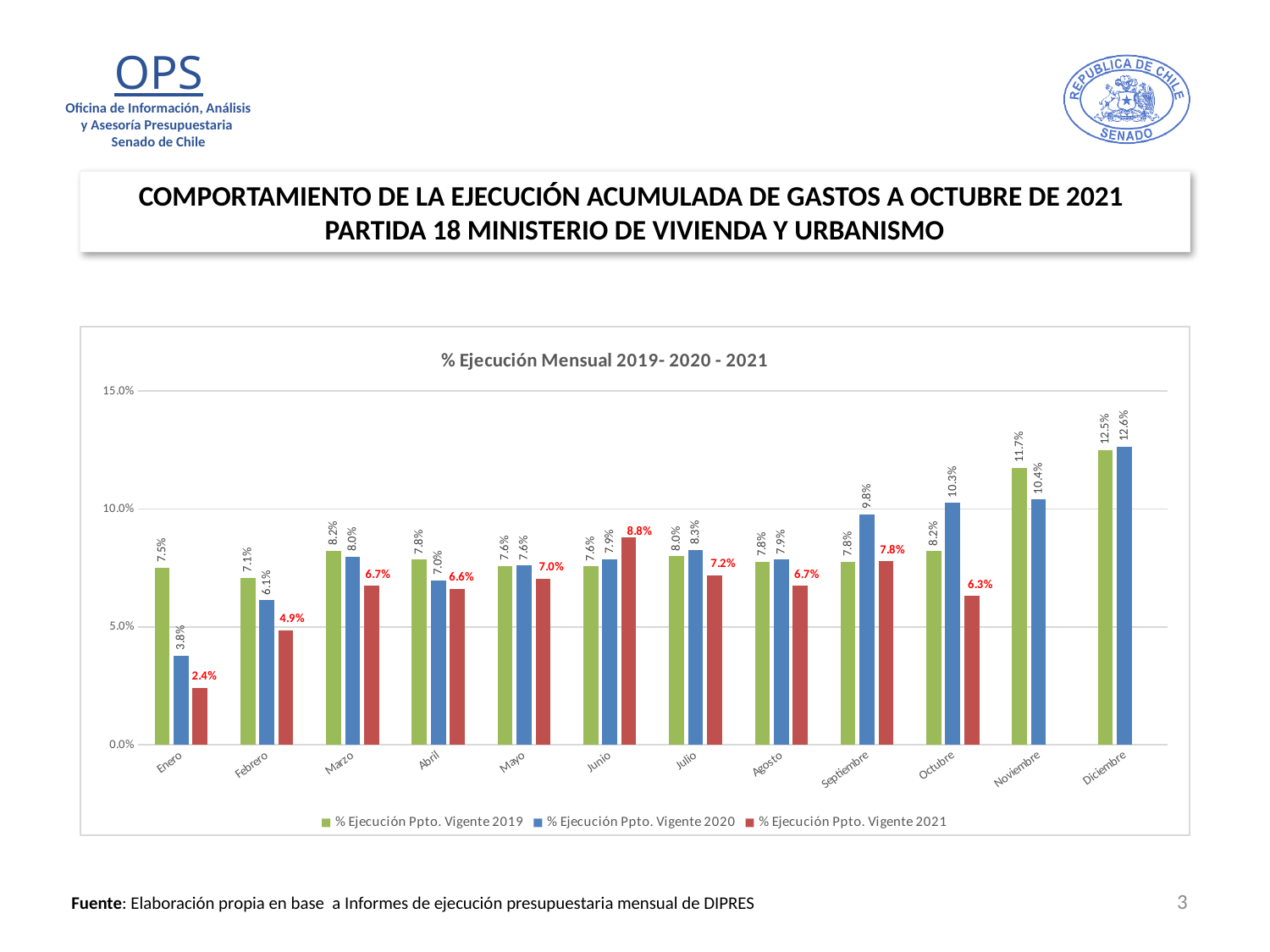
Is the value for % Ejecución Ppto. Vigente 2019 in Diciembre greater or less than 10.0%? greater How many months are shown on the x axis? 12 In which month is the % Ejecución Ppto. Vigente 2020 series lowest? Enero What is the difference between the 2020 and 2021 values in Octubre? 4.0% Which is larger in Septiembre: the 2020 value or the 2019 value? 2020 value (9.8%) What is the value for % Ejecución Ppto. Vigente 2021 in Enero? 2.4% What is the title of the chart? % Ejecución Mensual 2019- 2020 - 2021 What kind of chart is shown on the slide? Bar chart What is the value for % Ejecución Ppto. Vigente 2019 in Noviembre? 11.7% In which month is the % Ejecución Ppto. Vigente 2021 series highest? Junio What is the value for % Ejecución Ppto. Vigente 2020 in Octubre? 10.3% How many series does the legend list? 3